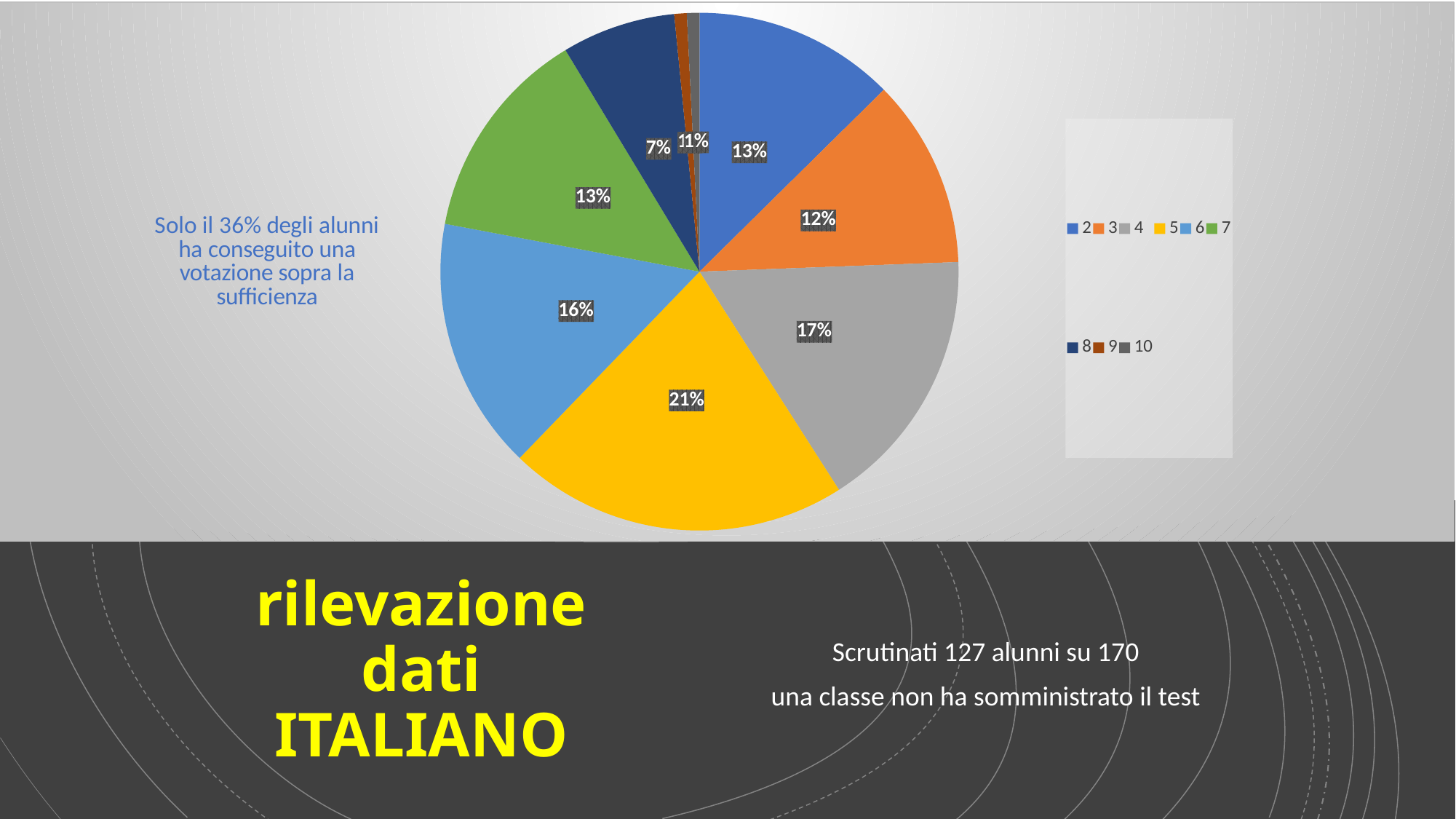
What colour is the slice for category 5? yellow What kind of chart is shown on the slide? pie chart What percentage is shown for category 3? 12% What share of the pie does category 5 have? 21% What is the difference in percentage points between category 5 and category 4? 4 Which has a larger share, category 6 or category 3? 6 What percentage is shown for category 2? 13% Which category has the largest slice of the pie? 5 What percentage is shown for category 4? 17% How many categories does the legend list? 9 What percentage is shown for category 8? 7% What percentage is shown for category 6? 16%